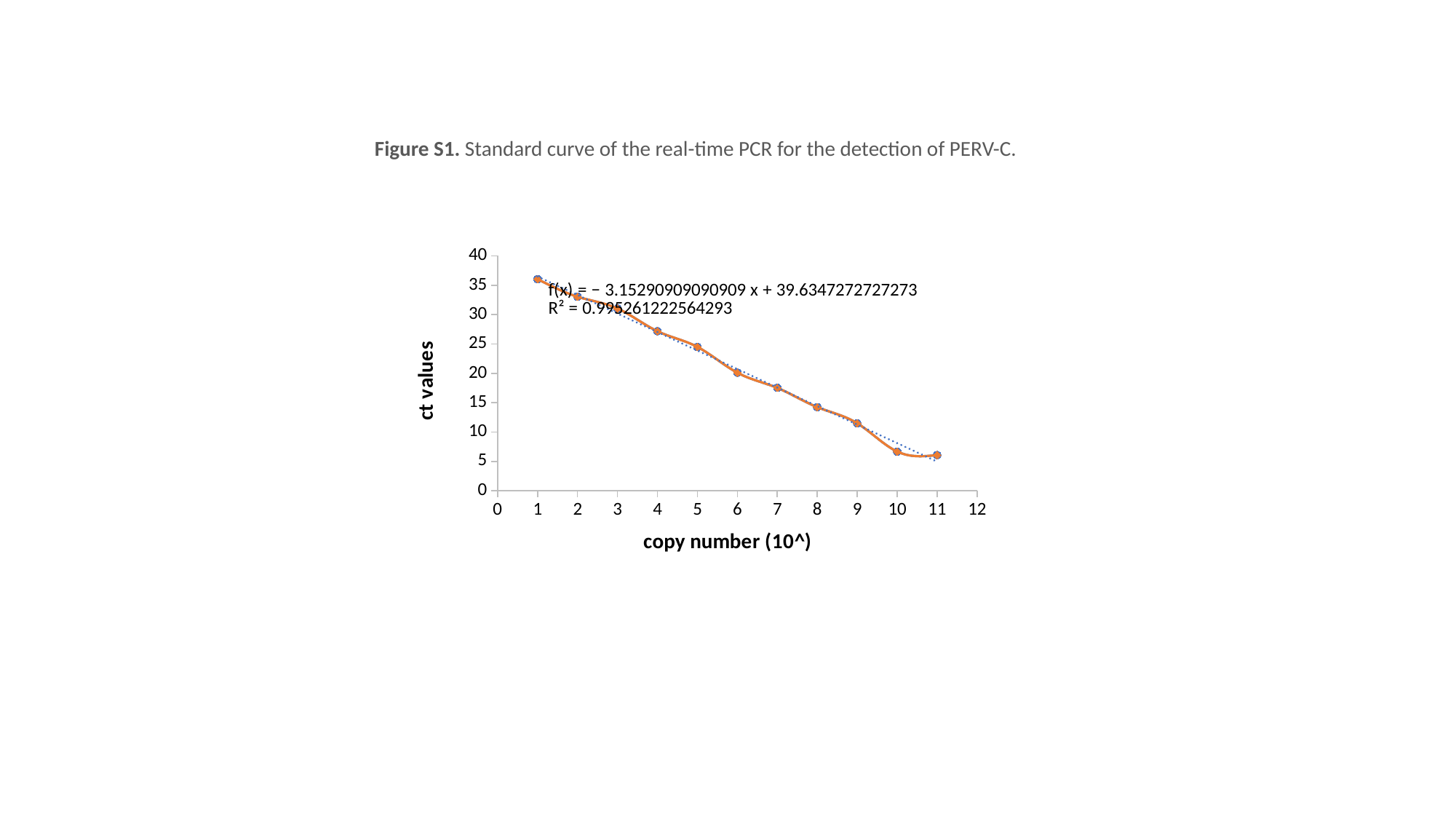
Is the ct value at copy number 4 greater or less than 25? greater What is the title of the y axis? ct values What kind of chart is shown on the slide? scatter chart Is the ct value at copy number 2 greater or less than 30? greater At which copy number (10^) is the ct value highest? 1 Do the ct values rise or fall as copy number increases along the x axis? fall Is the ct value at copy number 8 greater or less than 15? less How many data points are plotted on the chart? 11 What is the R² value printed on the chart? 0.995261222564293 Which has the larger ct value: copy number 3 or copy number 9? copy number 3